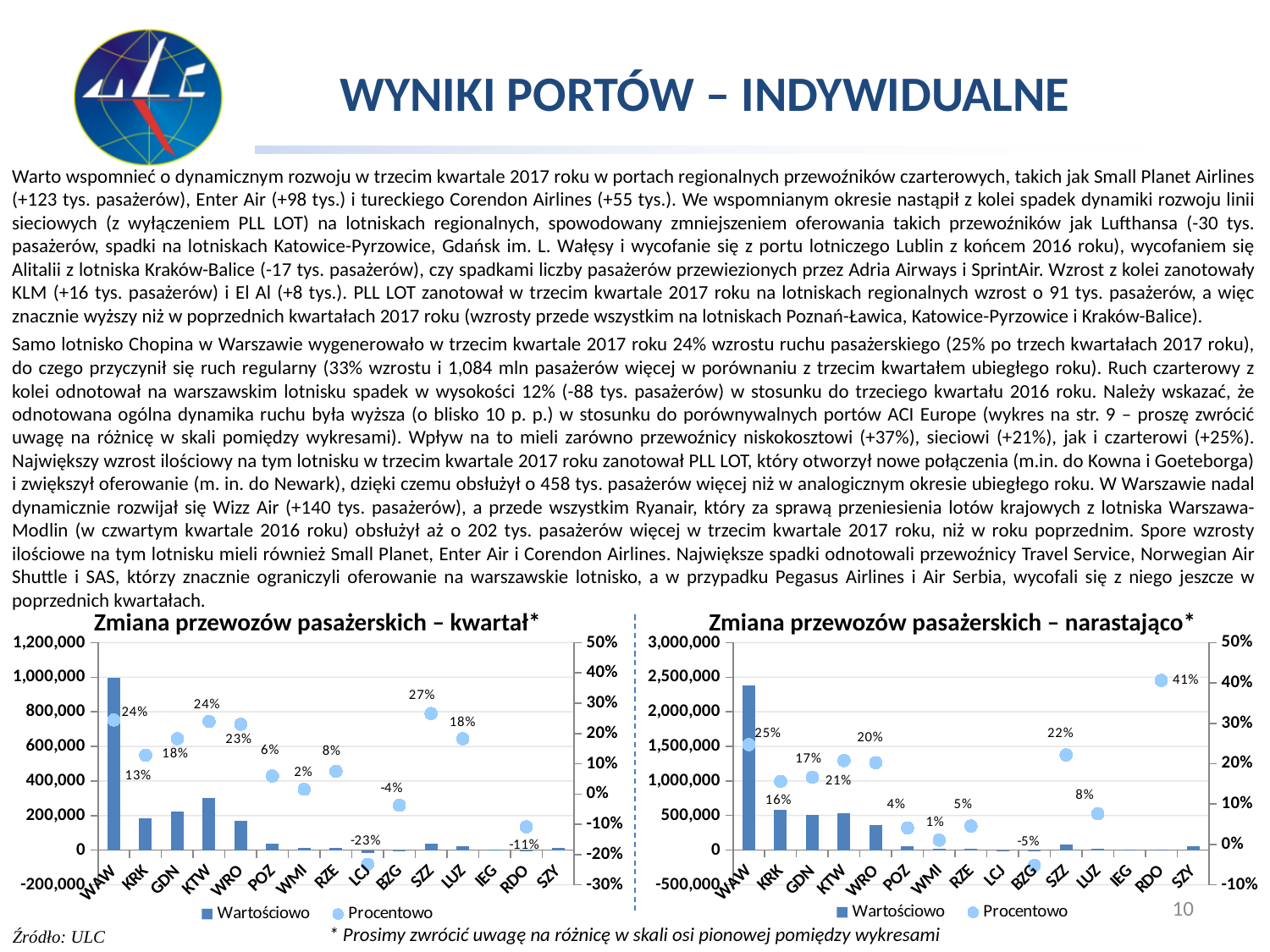
In the left chart (Zmiana przewozów pasażerskich – kwartał), which airport has the highest labelled percentage change? SZZ In the right chart (Zmiana przewozów pasażerskich – narastająco), what is the percentage change shown for RDO? 41% In the left chart (Zmiana przewozów pasażerskich – kwartał), what is the percentage change shown for LCJ? -23% In the right chart (Zmiana przewozów pasażerskich – narastająco), which airport has the highest labelled percentage change? RDO In the left chart (Zmiana przewozów pasażerskich – kwartał), what is the percentage change shown for SZZ? 27% In the right chart (Zmiana przewozów pasażerskich – narastająco), which has the larger labelled percentage change, GDN or SZZ? SZZ In the left chart (Zmiana przewozów pasażerskich – kwartał), is the Wartościowo bar for WAW greater or less than 800,000? greater How many series does the legend of the left chart (Zmiana przewozów pasażerskich – kwartał) list? 2 In the left chart (Zmiana przewozów pasażerskich – kwartał), what is the difference in percentage points between the labelled values for WAW and KRK? 11 percentage points In the left chart (Zmiana przewozów pasażerskich – kwartał), which airport has the lowest labelled percentage change? LCJ How many airports are listed on the x axis of the right chart (Zmiana przewozów pasażerskich – narastająco)? 15 In the right chart (Zmiana przewozów pasażerskich – narastająco), what is the percentage change shown for BZG? -5%